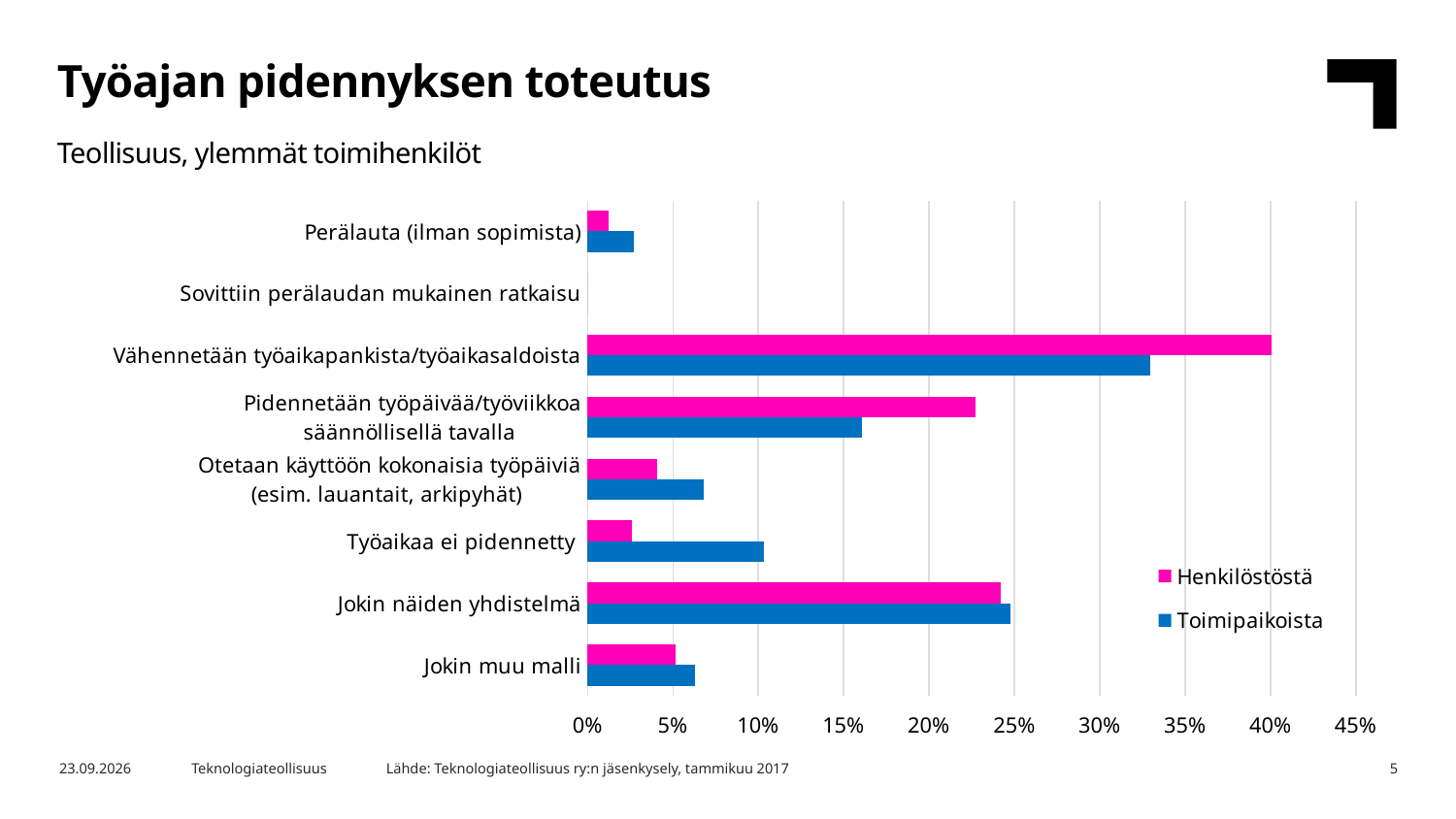
How many categories are shown on the chart? 8 For Työaikaa ei pidennetty, which series has the larger value, Henkilöstöstä or Toimipaikoista? Toimipaikoista For Pidennetään työpäivää/työviikkoa säännöllisellä tavalla, which series has the larger value, Henkilöstöstä or Toimipaikoista? Henkilöstöstä Is the Toimipaikoista value for Työaikaa ei pidennetty greater or less than 5%? greater Is the Henkilöstöstä value for Pidennetään työpäivää/työviikkoa säännöllisellä tavalla greater or less than 25%? less Is the Toimipaikoista value for Vähennetään työaikapankista/työaikasaldoista greater or less than 30%? greater What kind of chart is shown on the slide? Bar chart Which category has the highest value for Henkilöstöstä? Vähennetään työaikapankista/työaikasaldoista Which category has the lowest value for Toimipaikoista? Sovittiin perälaudan mukainen ratkaisu Which category has the highest value for Toimipaikoista? Vähennetään työaikapankista/työaikasaldoista How many series does the legend list? 2